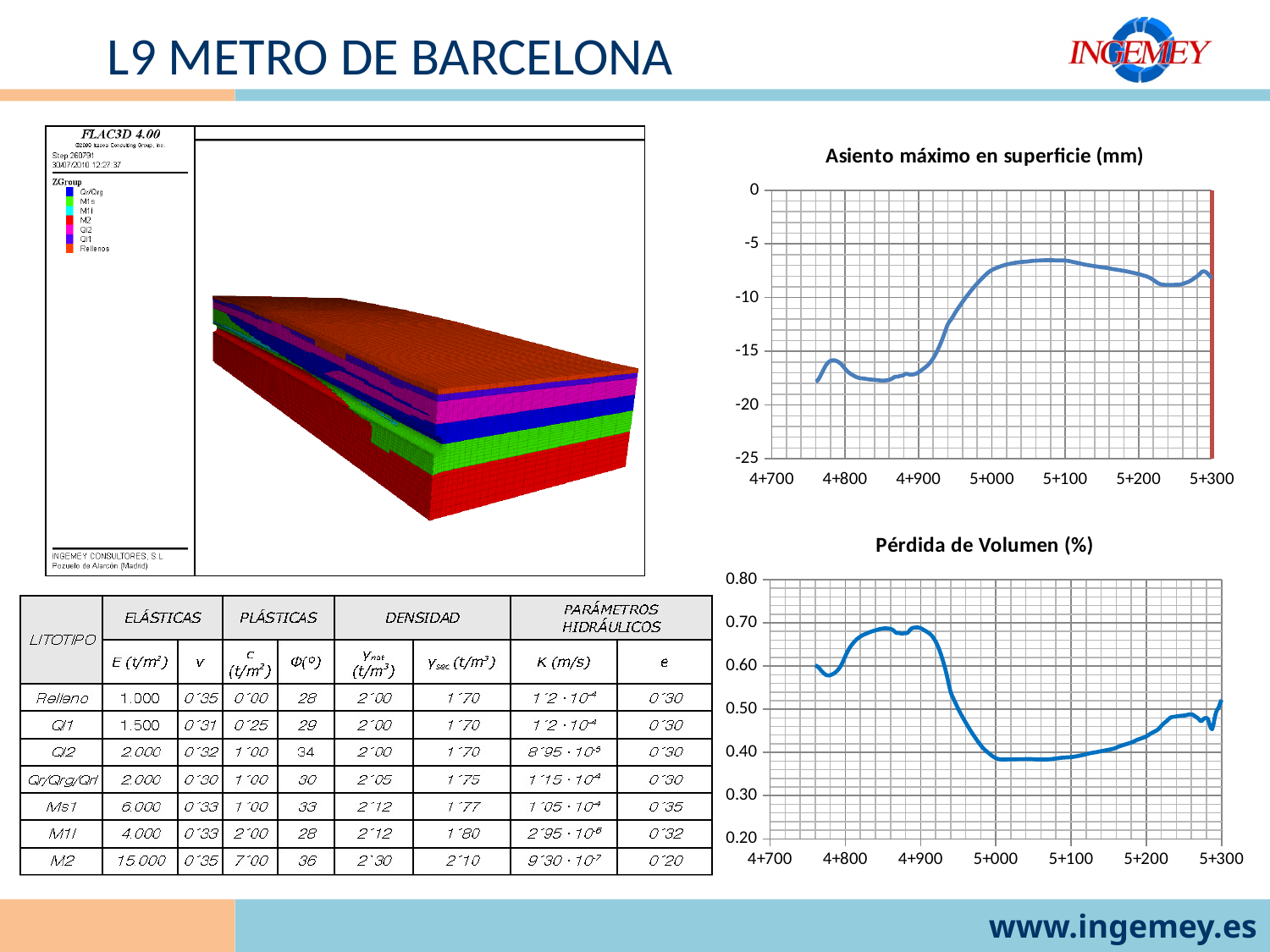
What kind of chart is the 'Pérdida de Volumen (%)' chart? line chart What kind of chart is the 'Asiento máximo en superficie (mm)' chart? line chart In the 'Pérdida de Volumen (%)' chart, is the value at 5+000 greater or less than 0.50? less In the 'Pérdida de Volumen (%)' chart, which is larger, the value at 4+900 or the value at 5+100? 4+900 In the 'Asiento máximo en superficie (mm)' chart, is the value at 5+100 greater or less than -10? greater In the 'Pérdida de Volumen (%)' chart, do the values rise or fall between 4+900 and 5+000? fall In the 'Asiento máximo en superficie (mm)' chart, is the value at 4+800 greater or less than -15? less In the 'Asiento máximo en superficie (mm)' chart, do the values rise or fall between 4+900 and 5+000? rise In the 'Asiento máximo en superficie (mm)' chart, which is larger, the value at 4+800 or the value at 5+100? 5+100 What is the title of the upper chart on the right side of the slide? Asiento máximo en superficie (mm) How many labelled tick marks are on the x axis of the 'Pérdida de Volumen (%)' chart? 7